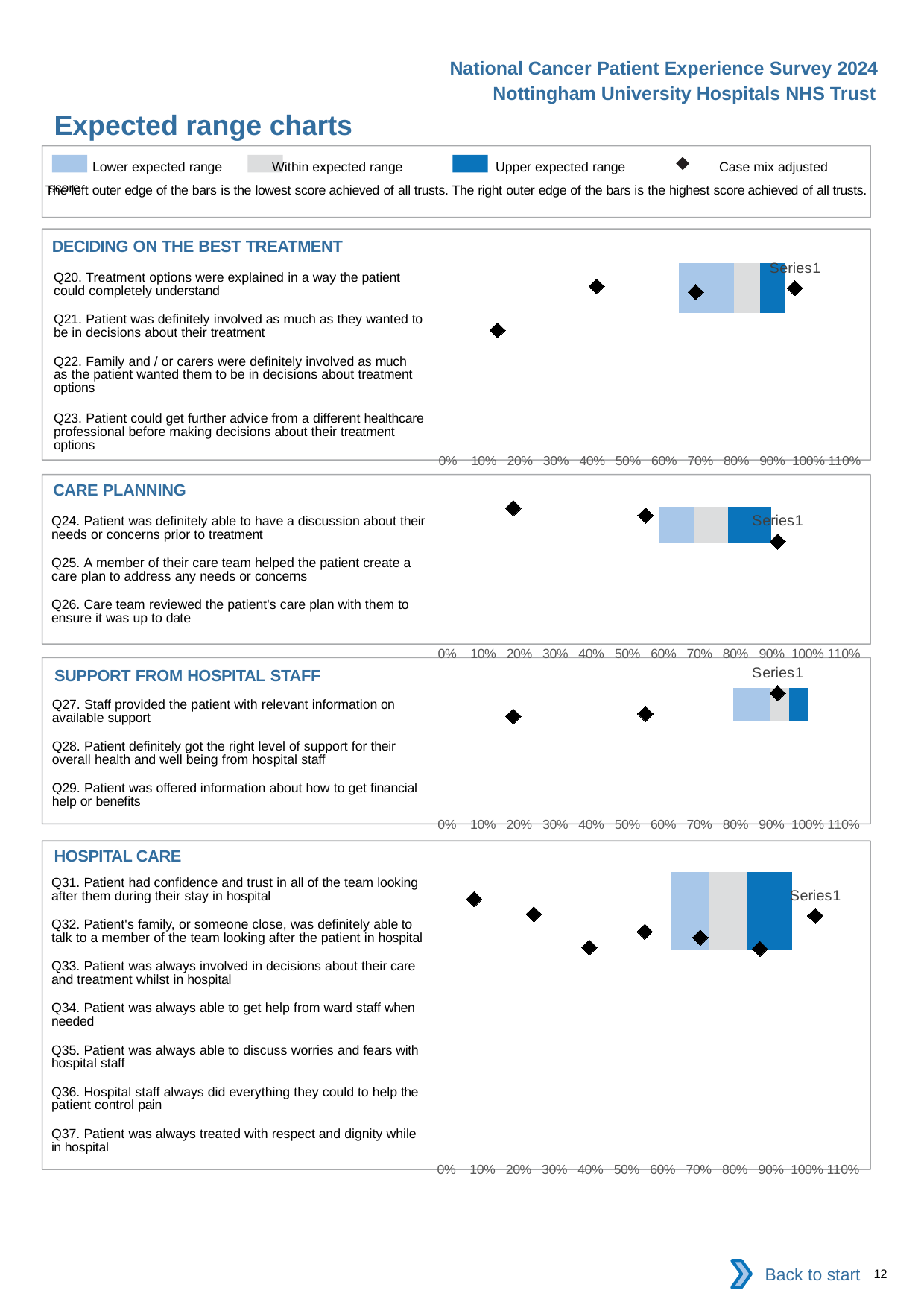
In the HOSPITAL CARE chart, is the rightmost case mix adjusted score marker greater or less than 80%? greater How many questions are listed in the HOSPITAL CARE chart? 7 Which legend entry is shown in the darkest blue colour? Upper expected range How many entries does the legend at the top of the slide list? 4 In the HOSPITAL CARE chart, is the leftmost case mix adjusted score marker greater or less than 20%? less How many case mix adjusted score markers (diamonds) are plotted in the HOSPITAL CARE chart? 7 In the CARE PLANNING chart, is the leftmost case mix adjusted score marker greater or less than 30%? less How many questions are listed in the DECIDING ON THE BEST TREATMENT chart? 4 What is the highest tick label shown on the x axis of the HOSPITAL CARE chart? 110% What kind of chart is used in the DECIDING ON THE BEST TREATMENT section? bar chart